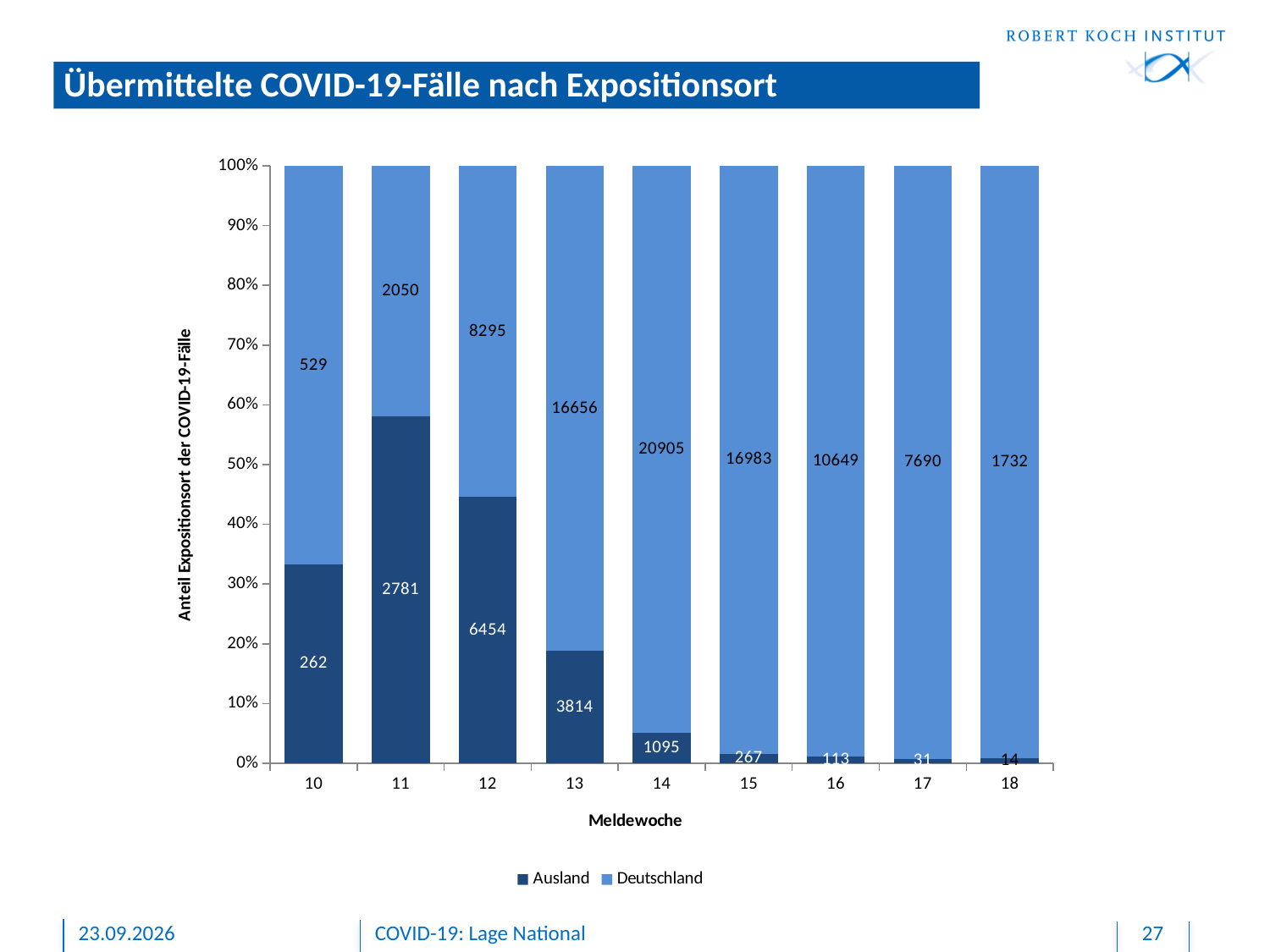
Which Meldewoche has the highest Deutschland value? 14 Is the Ausland share of the bar for Meldewoche 11 greater or less than 50%? greater What is the difference between the Deutschland values for Meldewoche 13 and Meldewoche 12? 8361 What kind of chart is shown on the slide? stacked bar chart What is the total of the Ausland and Deutschland values for Meldewoche 10? 791 What is the Ausland value for Meldewoche 12? 6454 Which Meldewoche has the lowest Ausland value? 18 What is the Ausland value for Meldewoche 18? 14 How many Meldewochen are shown on the x axis? 9 Which is larger, the Ausland value for Meldewoche 11 or the Ausland value for Meldewoche 13? Meldewoche 13 How many series does the legend list? 2 What is the Deutschland value for Meldewoche 14? 20905